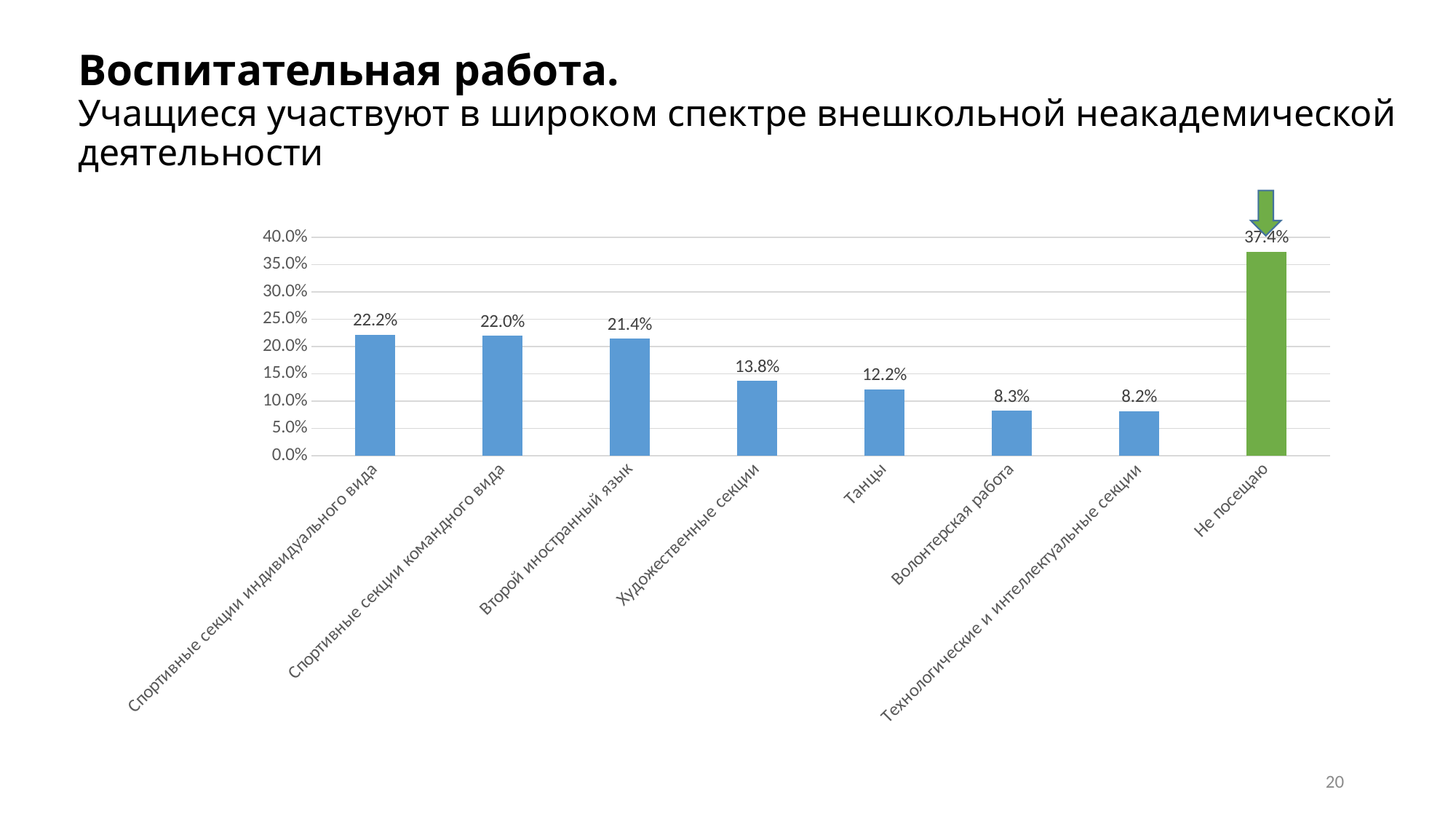
Which category has the highest value? Не посещаю What is the value for Танцы? 12.2% How many categories are shown on the x axis? 8 What kind of chart is shown on the slide? bar chart What is the value for Не посещаю? 37.4% What colour is the bar for Не посещаю? green What is the value for Волонтерская работа? 8.3% What is the difference between Не посещаю and Спортивные секции индивидуального вида? 15.2 percentage points Is the value for Не посещаю greater or less than 35.0%? greater What is the value for Второй иностранный язык? 21.4% What is the difference between Художественные секции and Танцы? 1.6 percentage points Which is larger, Художественные секции or Танцы? Художественные секции